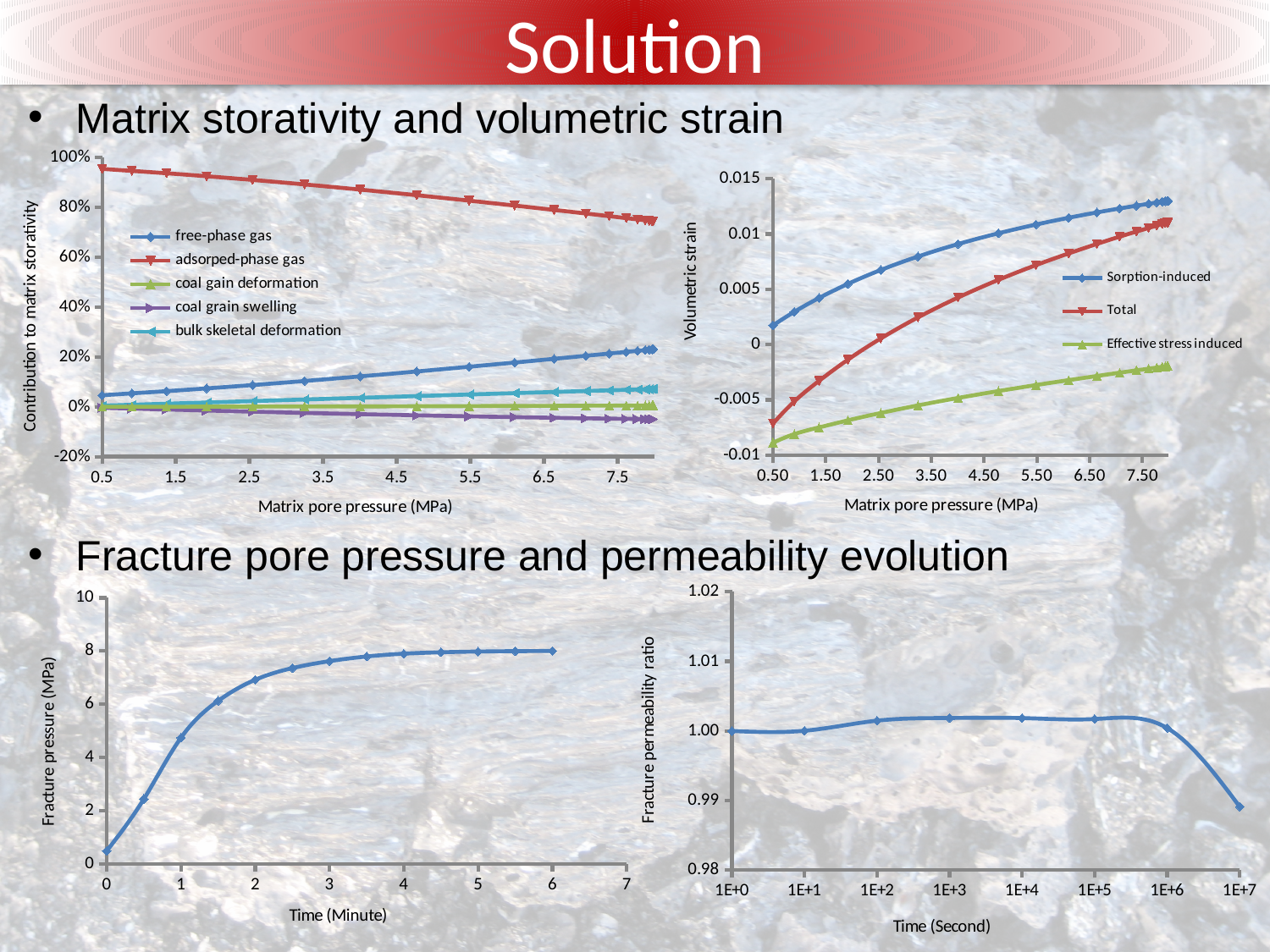
In the top-right chart (Volumetric strain), is the value for the Total series at 0.50 MPa greater or less than 0? less In the bottom-right chart (Fracture permeability ratio), is the value at 1E+7 seconds greater or less than 1.00? less What is the x-axis title of the bottom-right chart (Fracture permeability ratio)? Time (Second) How many series does the legend of the top-left chart (Contribution to matrix storativity) list? 5 What kind of chart is the top-left chart (Contribution to matrix storativity)? line chart In the bottom-left chart (Fracture pressure vs Time), is the fracture pressure at 4 minutes greater or less than 6 MPa? greater In the top-right chart (Volumetric strain), does the Sorption-induced series rise or fall as matrix pore pressure increases? rise In the top-left chart (Contribution to matrix storativity), does the adsorped-phase gas series rise or fall as matrix pore pressure increases? fall In the top-left chart (Contribution to matrix storativity), which series is larger at 0.5 MPa, adsorped-phase gas or free-phase gas? adsorped-phase gas How many series does the legend of the top-right chart (Volumetric strain) list? 3 In the top-left chart (Contribution to matrix storativity), does the free-phase gas series rise or fall as matrix pore pressure increases? rise